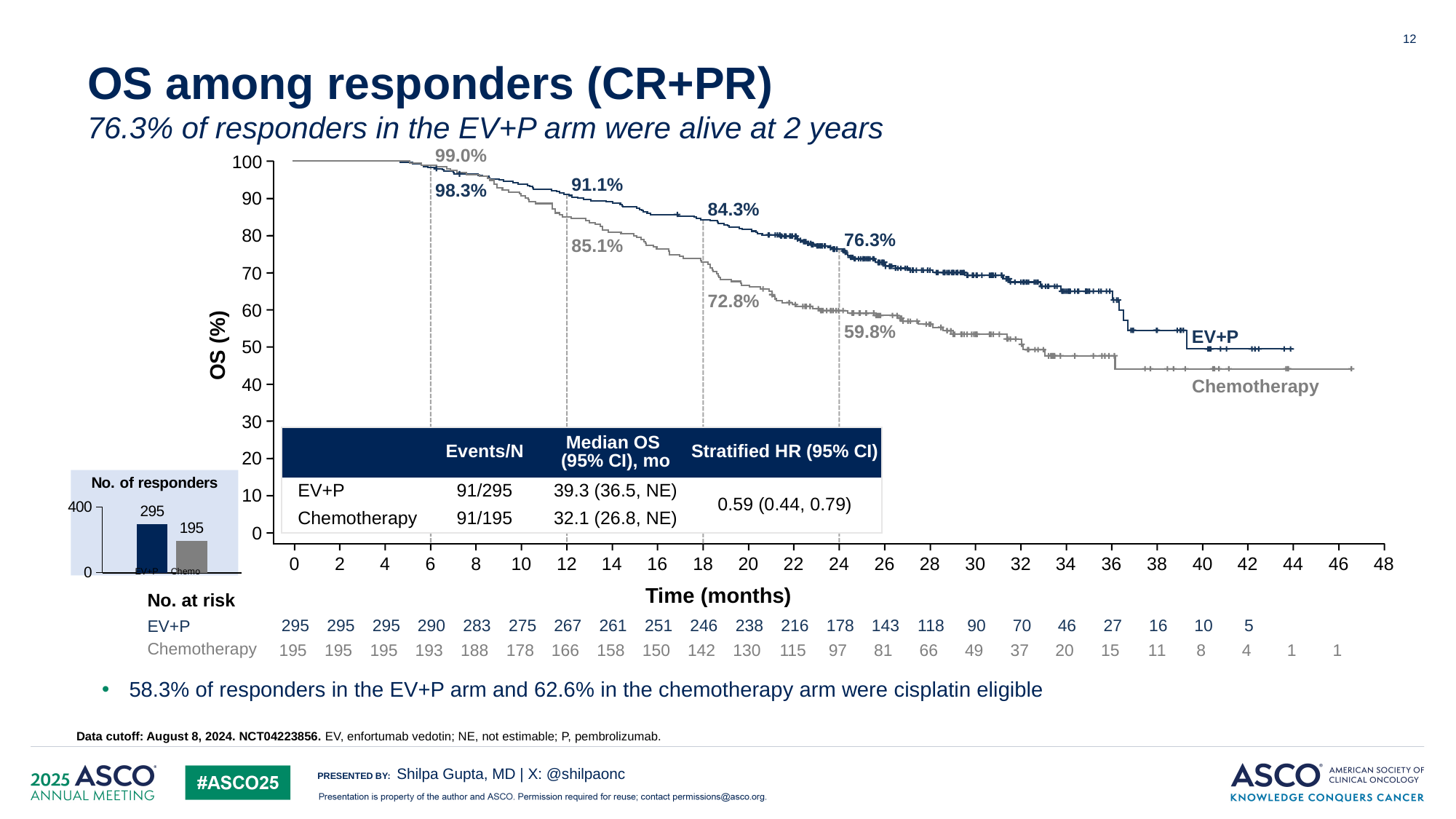
What kind of chart is the small 'No. of responders' chart? Bar chart In the OS curve chart, which arm has the higher OS percentage at 18 months, EV+P or Chemotherapy? EV+P In the OS curve chart, what is the difference between the EV+P and Chemotherapy OS percentages at 24 months? 16.5 percentage points In the 'No. of responders' bar chart, what is the difference between the EV+P and Chemo bars? 100 In the 'No. of responders' bar chart, what is the value for Chemo? 195 In the OS curve chart, do the curves rise or fall as time in months increases? Fall In the OS curve chart, what is the OS percentage for EV+P at 24 months? 76.3% In the 'No. of responders' bar chart, what is the value for EV+P? 295 In the 'No. of responders' bar chart, which group has the higher bar? EV+P In the OS curve chart, what is the OS percentage for Chemotherapy at 18 months? 72.8% In the OS curve chart, what is the OS percentage for EV+P at 12 months? 91.1% In the OS curve chart, what is the OS percentage for Chemotherapy at 24 months? 59.8%